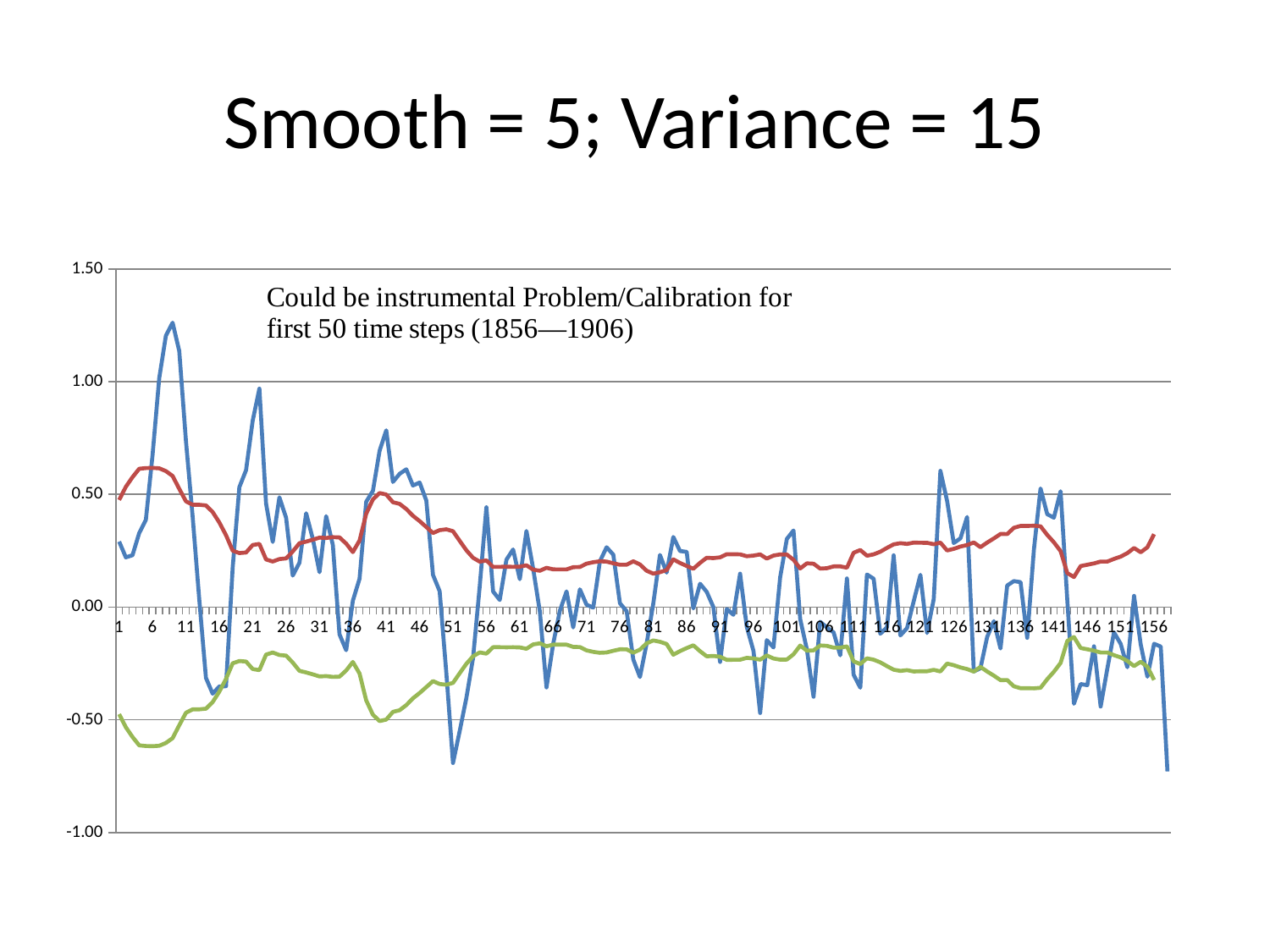
What is the title of the slide? Smooth = 5; Variance = 15 Which line reaches the highest value anywhere on the chart? the blue line Is the value of the green line at x = 6 greater or less than -0.50? less What kind of chart is shown on the slide? line chart Is the peak of the blue line near x = 9 greater or less than 1.00? greater How many lines are plotted on the chart? 3 Is the value of the red line at x = 6 greater or less than 0.50? greater Does the red line rise or fall between x = 6 and x = 16? fall What is the highest value shown on the y axis? 1.50 At x = 1, which is larger, the red line or the blue line? the red line What is the last label shown on the x axis? 156